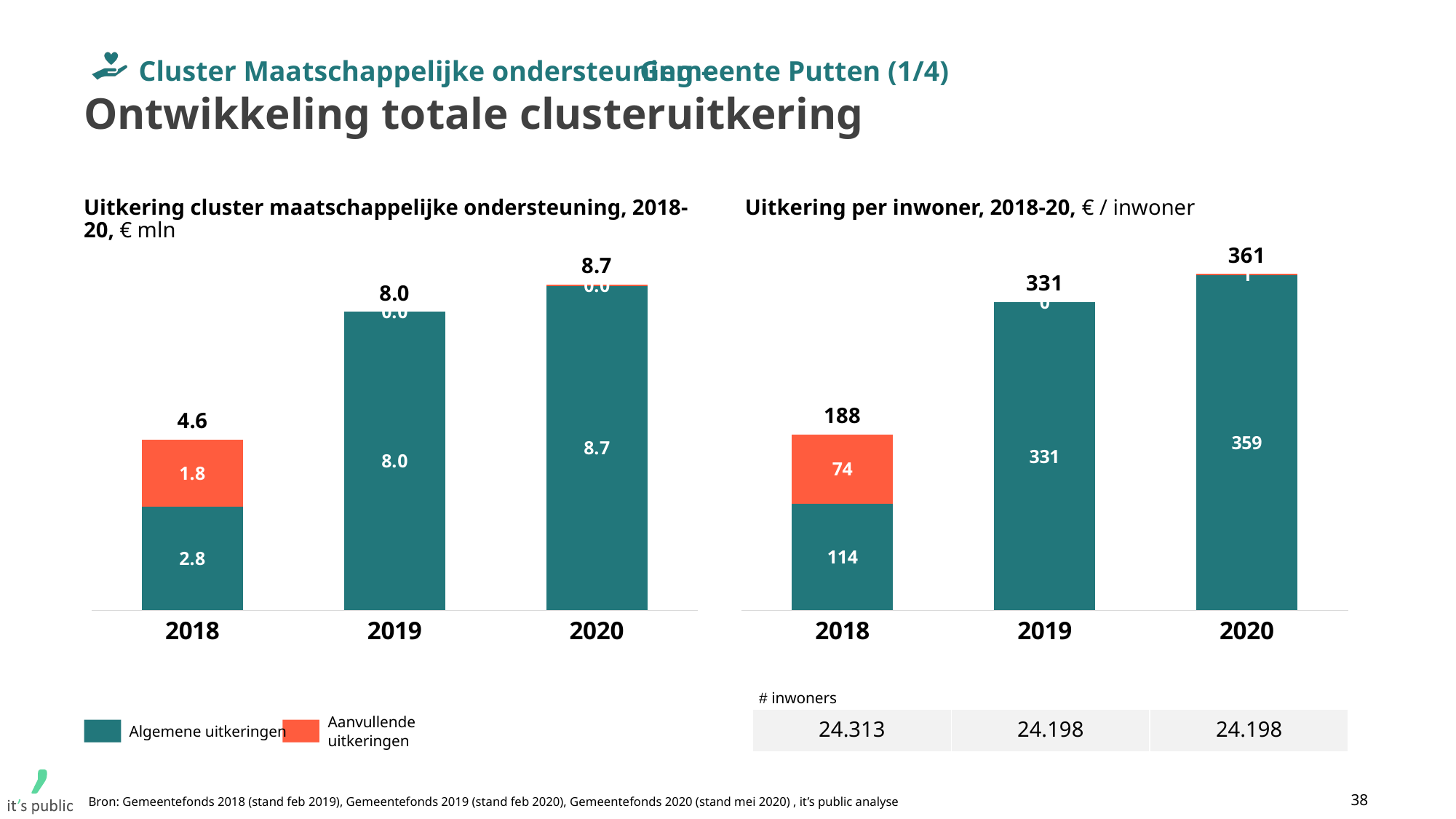
In the right chart (Uitkering per inwoner), what is the total for 2018? 188 In the right chart (Uitkering per inwoner), what is the difference between the 2019 total and the 2018 total? 143 What kind of chart is the left chart (Uitkering cluster maatschappelijke ondersteuning)? Stacked bar chart In the right chart (Uitkering per inwoner), what is the value of Algemene uitkeringen in 2020? 359 In the right chart (Uitkering per inwoner), what is the value of Aanvullende uitkeringen in 2018? 74 In the left chart (Uitkering cluster maatschappelijke ondersteuning), what is the difference between the 2020 total and the 2018 total? 4.1 In the left chart (Uitkering cluster maatschappelijke ondersteuning), which year has the highest total? 2020 In the left chart (Uitkering cluster maatschappelijke ondersteuning), what is the value of Algemene uitkeringen in 2019? 8.0 In the right chart (Uitkering per inwoner), which year has the lowest total? 2018 In the left chart (Uitkering cluster maatschappelijke ondersteuning), what is the total for 2018? 4.6 In the left chart (Uitkering cluster maatschappelijke ondersteuning), what is the value of Aanvullende uitkeringen in 2018? 1.8 How many series does the legend list for the left chart? 2